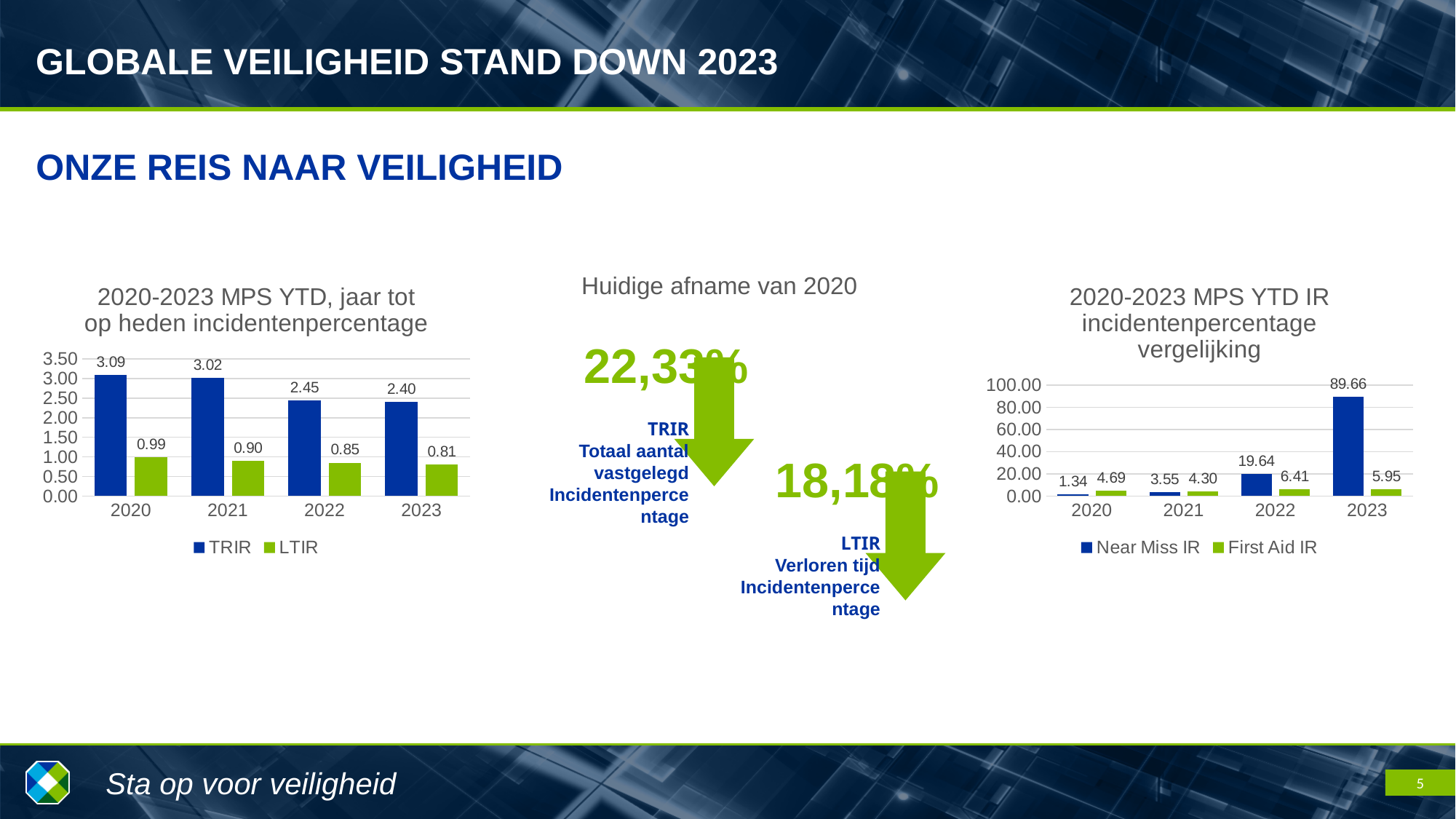
In the left chart (2020-2023 MPS YTD, jaar tot op heden incidentenpercentage), what is the difference between the TRIR values for 2020 and 2023? 0.69 In the right chart (2020-2023 MPS YTD IR incidentenpercentage vergelijking), what is the First Aid IR value for 2022? 6.41 In the left chart (2020-2023 MPS YTD, jaar tot op heden incidentenpercentage), what is the TRIR value for 2020? 3.09 In the right chart (2020-2023 MPS YTD IR incidentenpercentage vergelijking), what is the difference between the Near Miss IR values for 2023 and 2022? 70.02 In the right chart (2020-2023 MPS YTD IR incidentenpercentage vergelijking), which year has the highest Near Miss IR value? 2023 In the left chart (2020-2023 MPS YTD, jaar tot op heden incidentenpercentage), what is the LTIR value for 2023? 0.81 In the right chart (2020-2023 MPS YTD IR incidentenpercentage vergelijking), which is larger in 2020: Near Miss IR or First Aid IR? First Aid IR In the left chart (2020-2023 MPS YTD, jaar tot op heden incidentenpercentage), how many series does the legend list? 2 What kind of chart is the right chart (2020-2023 MPS YTD IR incidentenpercentage vergelijking)? bar chart In the left chart (2020-2023 MPS YTD, jaar tot op heden incidentenpercentage), which year has the lowest TRIR value? 2023 In the left chart (2020-2023 MPS YTD, jaar tot op heden incidentenpercentage), does the TRIR series rise or fall from 2020 to 2023? fall In the right chart (2020-2023 MPS YTD IR incidentenpercentage vergelijking), what is the Near Miss IR value for 2023? 89.66